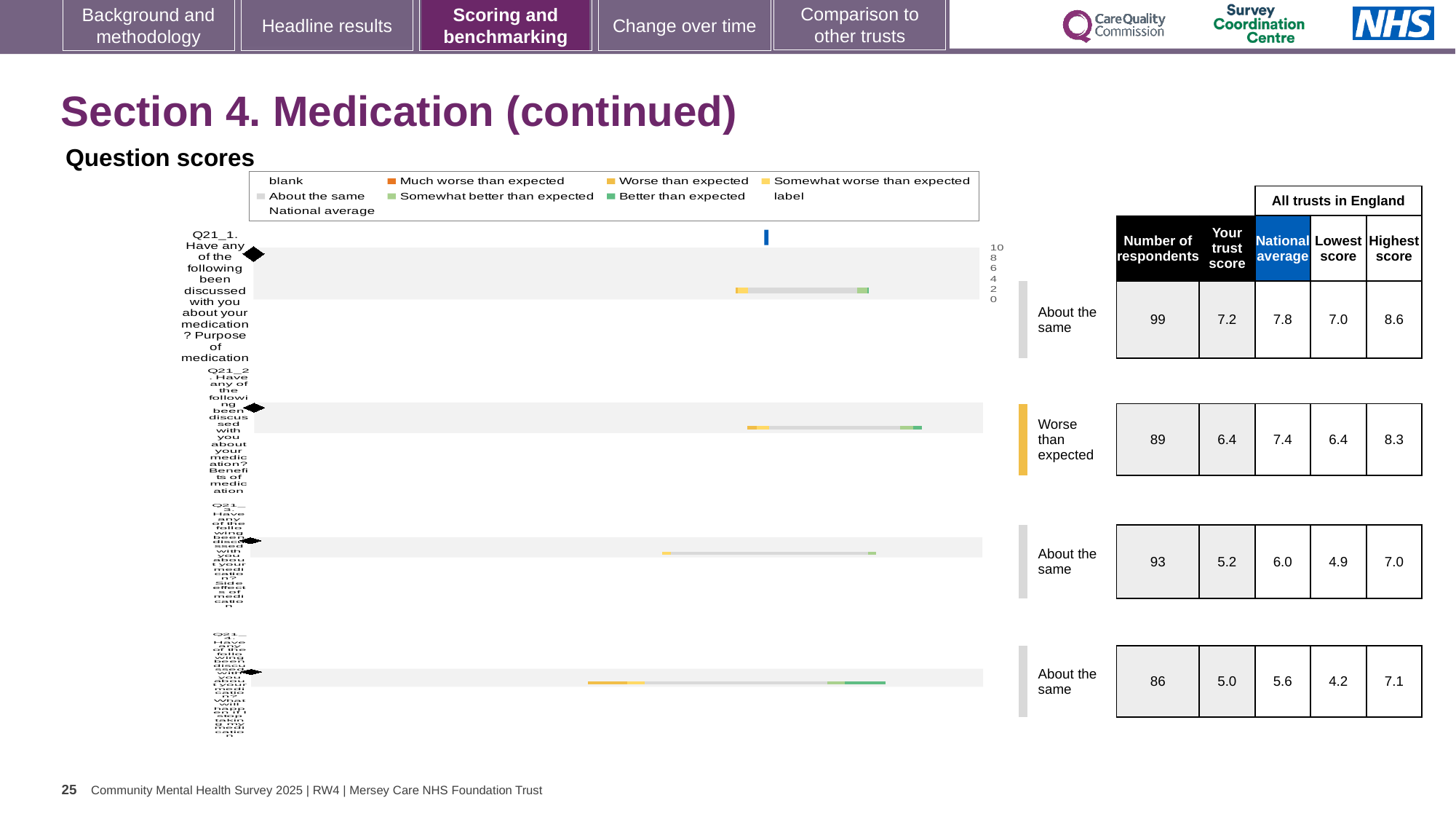
What benchmark category is shown next to the bar for Q21_2? Worse than expected What is the national average for Q21_2 (Benefits of medication)? 7.4 What is the highest score among all trusts in England for Q21_4? 7.1 What kind of chart is shown under 'Question scores'? bar chart What is the 'Your trust score' for Q21_1 (Purpose of medication)? 7.2 Which question has the highest 'Your trust score'? Q21_1 For Q21_2, which is larger: the trust score or the national average? National average How many respondents are listed for Q21_3? 93 For Q21_1, how much higher is the national average than the trust score? 0.6 What is the lowest score among all trusts in England for Q21_3? 4.9 How many questions (bars) are plotted in the Question scores chart? 4 Which question has the lowest 'Your trust score'? Q21_4